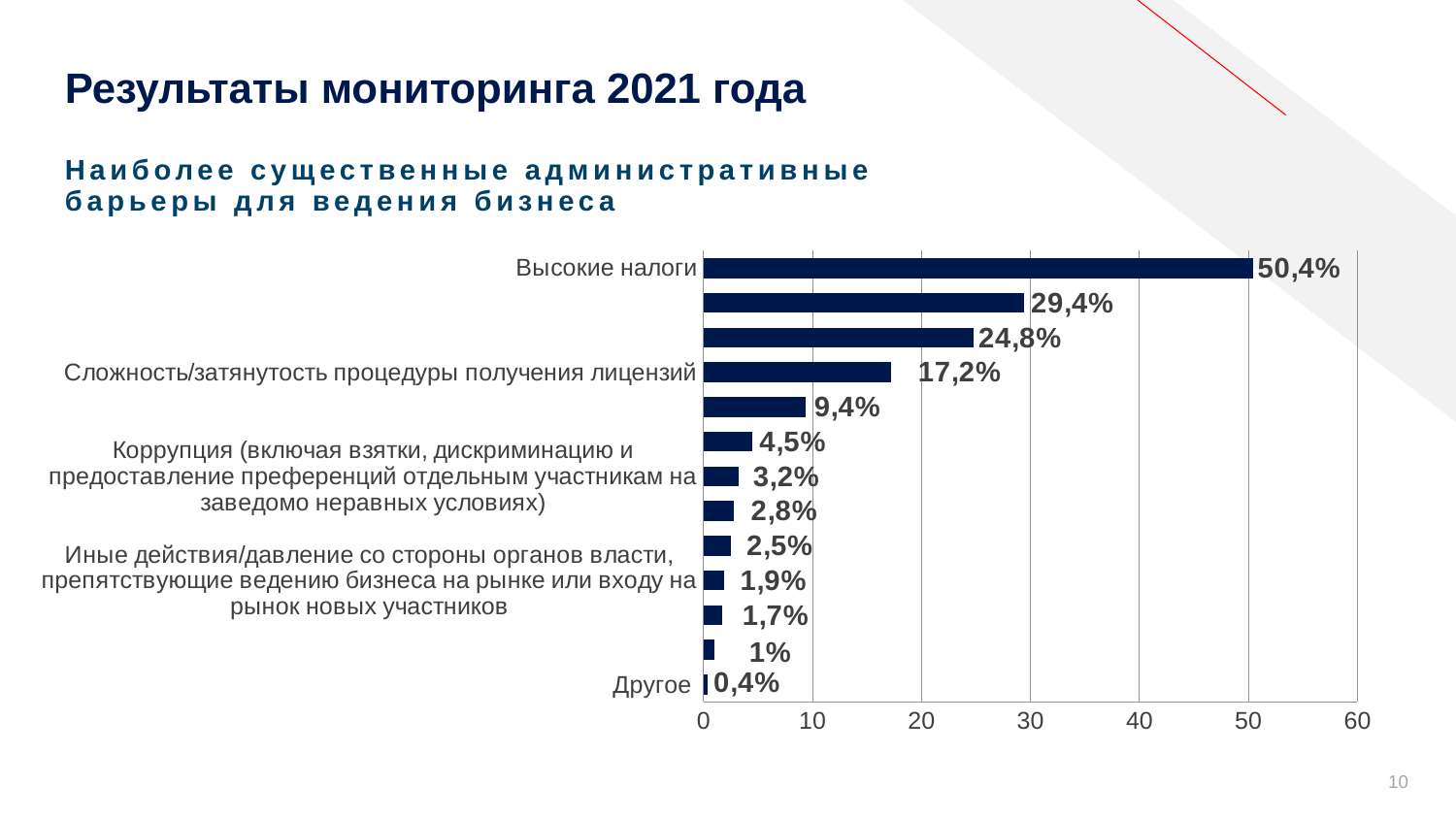
What value is shown for «Иные действия/давление со стороны органов власти, препятствующие ведению бизнеса на рынке или входу на рынок новых участников»? 1,9% Is the value for «Высокие налоги» greater or less than 40? greater What value is shown for «Сложность/затянутость процедуры получения лицензий»? 17,2% Which category has the lowest value in the chart? Другое How many bars are plotted in the chart? 13 What value is shown for «Высокие налоги»? 50,4% Which is larger: the value for «Коррупция» or the value for «Иные действия/давление со стороны органов власти»? Коррупция What type of chart is shown on the slide? Bar chart What is the difference between the values for «Высокие налоги» and «Сложность/затянутость процедуры получения лицензий»? 33,2% What value is shown for «Коррупция (включая взятки, дискриминацию и предоставление преференций отдельным участникам на заведомо неравных условиях)»? 3,2% Which category has the highest value in the chart? Высокие налоги What value is shown for «Другое»? 0,4%